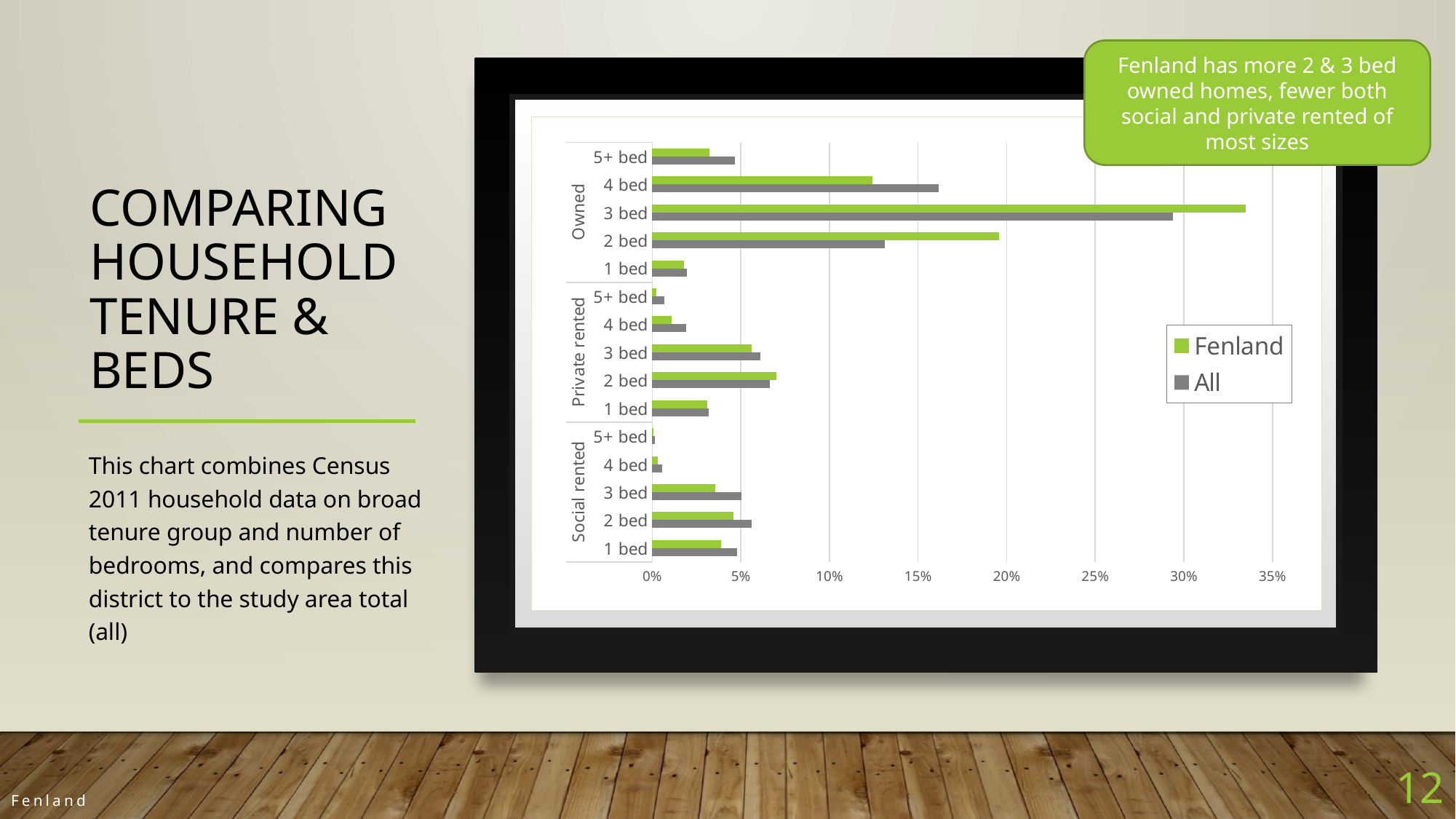
What kind of chart is shown on the slide? Bar chart For Owned 2 bed homes, which series has the larger value, Fenland or All? Fenland How many bedroom categories are plotted in total across the three tenure groups? 15 Is the Fenland value for Owned 3 bed homes greater or less than 30%? greater Which tenure group and bedroom category has the highest value for Fenland? Owned, 3 bed Is the Fenland value for Social rented 3 bed homes greater or less than 5%? less Which two series are listed in the chart legend? Fenland and All Is the All value for Owned 2 bed homes greater or less than 10%? greater Which tenure group and bedroom category has the lowest value for Fenland? Social rented, 5+ bed Which colour represents the Fenland series in the chart? Green For Owned 4 bed homes, which series has the larger value, Fenland or All? All How many series does the chart legend list? 2